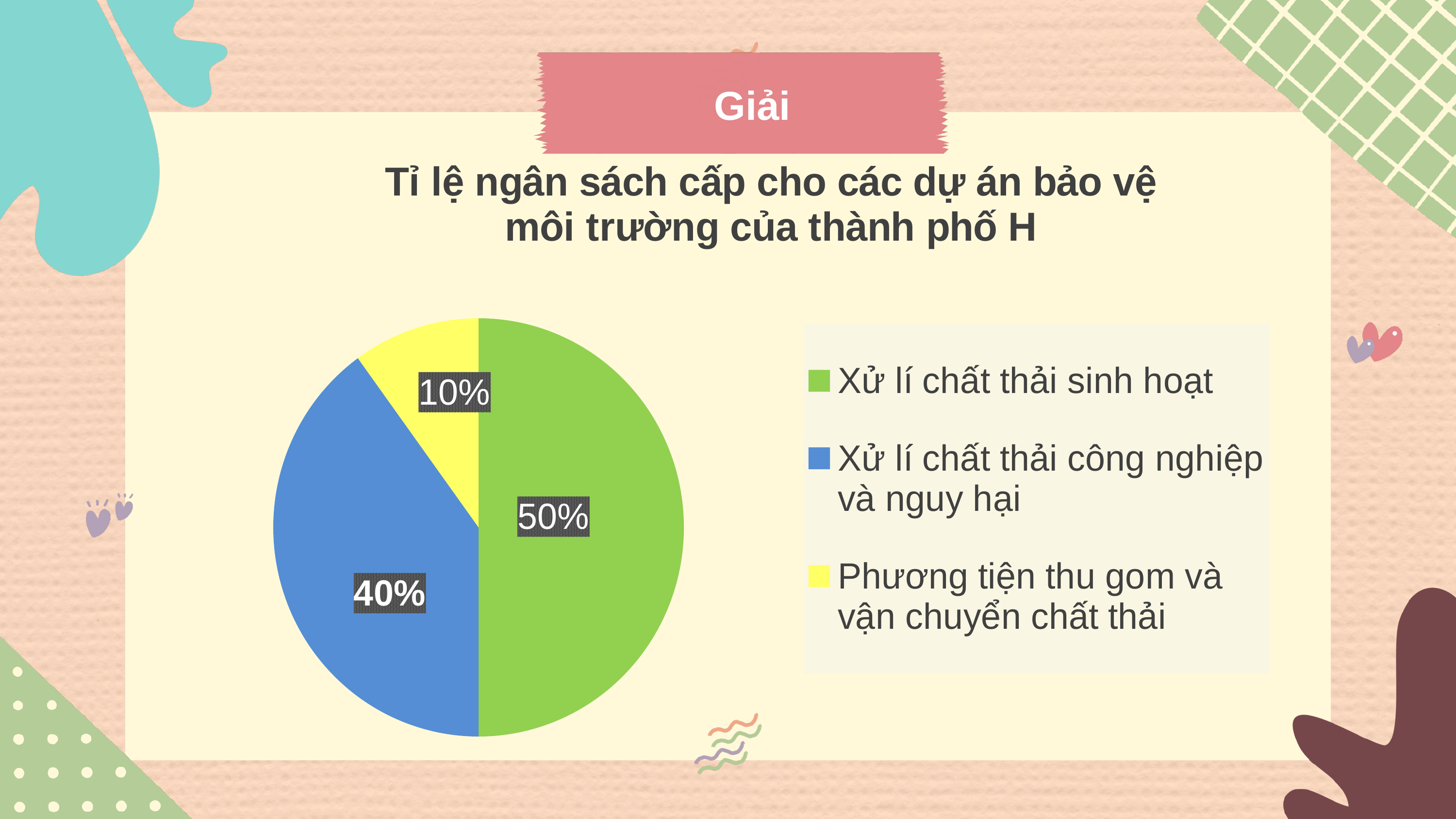
Which category receives the smallest share of the budget? Phương tiện thu gom và vận chuyển chất thải How many categories does the pie chart show? 3 What colour represents "Phương tiện thu gom và vận chuyển chất thải" in the pie chart? Yellow What is the difference in percentage points between "Xử lí chất thải công nghiệp và nguy hại" and "Phương tiện thu gom và vận chuyển chất thải"? 30% What percentage of the budget goes to "Phương tiện thu gom và vận chuyển chất thải"? 10% What kind of chart is shown on the slide? Pie chart Which category receives the largest share of the budget? Xử lí chất thải sinh hoạt What is the title of the chart? Tỉ lệ ngân sách cấp cho các dự án bảo vệ môi trường của thành phố H What percentage of the budget goes to "Xử lí chất thải công nghiệp và nguy hại"? 40% What percentage of the budget goes to "Xử lí chất thải sinh hoạt"? 50% Which is larger: the share for "Xử lí chất thải công nghiệp và nguy hại" or the share for "Phương tiện thu gom và vận chuyển chất thải"? Xử lí chất thải công nghiệp và nguy hại What is the difference in percentage points between "Xử lí chất thải sinh hoạt" and "Xử lí chất thải công nghiệp và nguy hại"? 10%